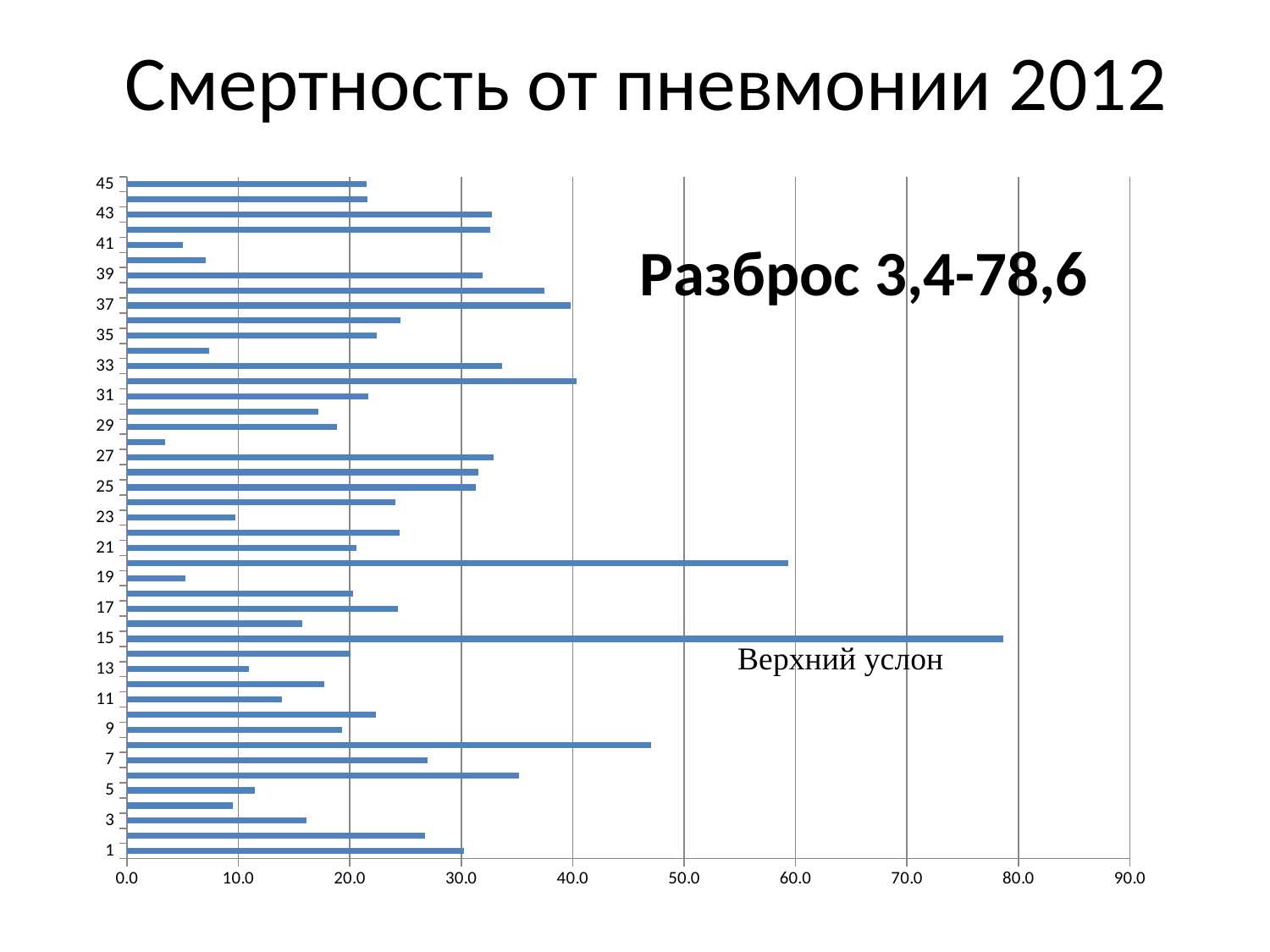
Which has the larger value, category 32 or category 34? 32 How many categories are plotted in the chart? 45 Is the value for category 15 greater or less than 70? greater Is the value for category 8 greater or less than 40? greater What is the title of the slide? Смертность от пневмонии 2012 Which category has the highest value in the chart? 15 Is the value for category 36 greater or less than 30? less What range of values does the text on the slide state (Разброс)? 3,4-78,6 What kind of chart is shown on the slide? bar chart Which has the larger value, category 15 or category 20? 15